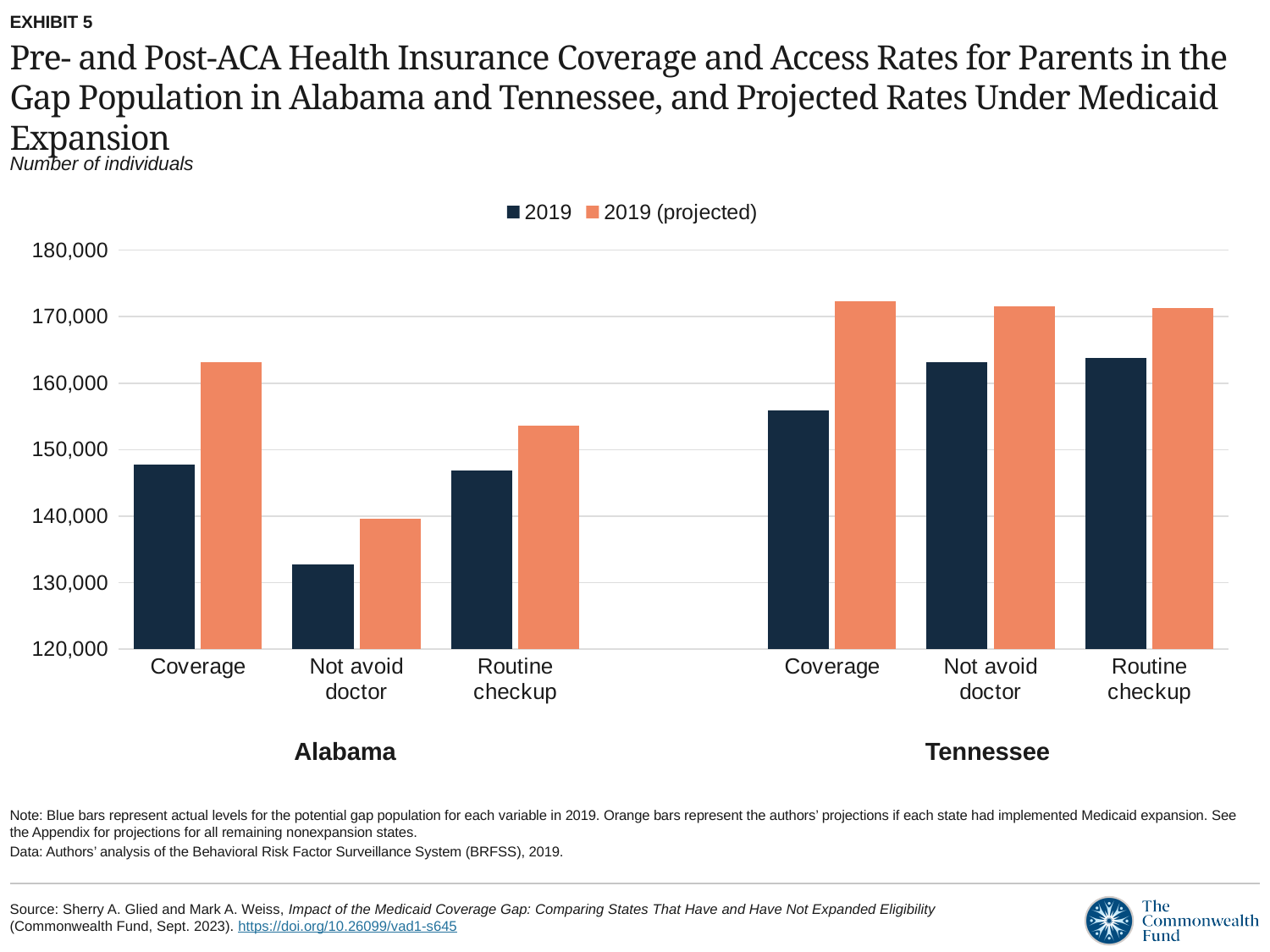
Which category in Alabama has the lowest 2019 value? Not avoid doctor Is the 2019 value for Coverage in Tennessee greater or less than 150,000? greater What are the two series named in the legend? 2019 and 2019 (projected) What kind of chart is shown on the slide? bar chart Is the 2019 (projected) value for Coverage in Tennessee greater or less than 170,000? greater How many categories are plotted across both states on the x axis? 6 How many series does the legend list? 2 Is the 2019 value for Not avoid doctor in Alabama greater or less than 140,000? less Which is larger, the 2019 Coverage value for Alabama or the 2019 Coverage value for Tennessee? Tennessee Which is larger in Tennessee, the 2019 value for Coverage or the 2019 value for Not avoid doctor? Not avoid doctor